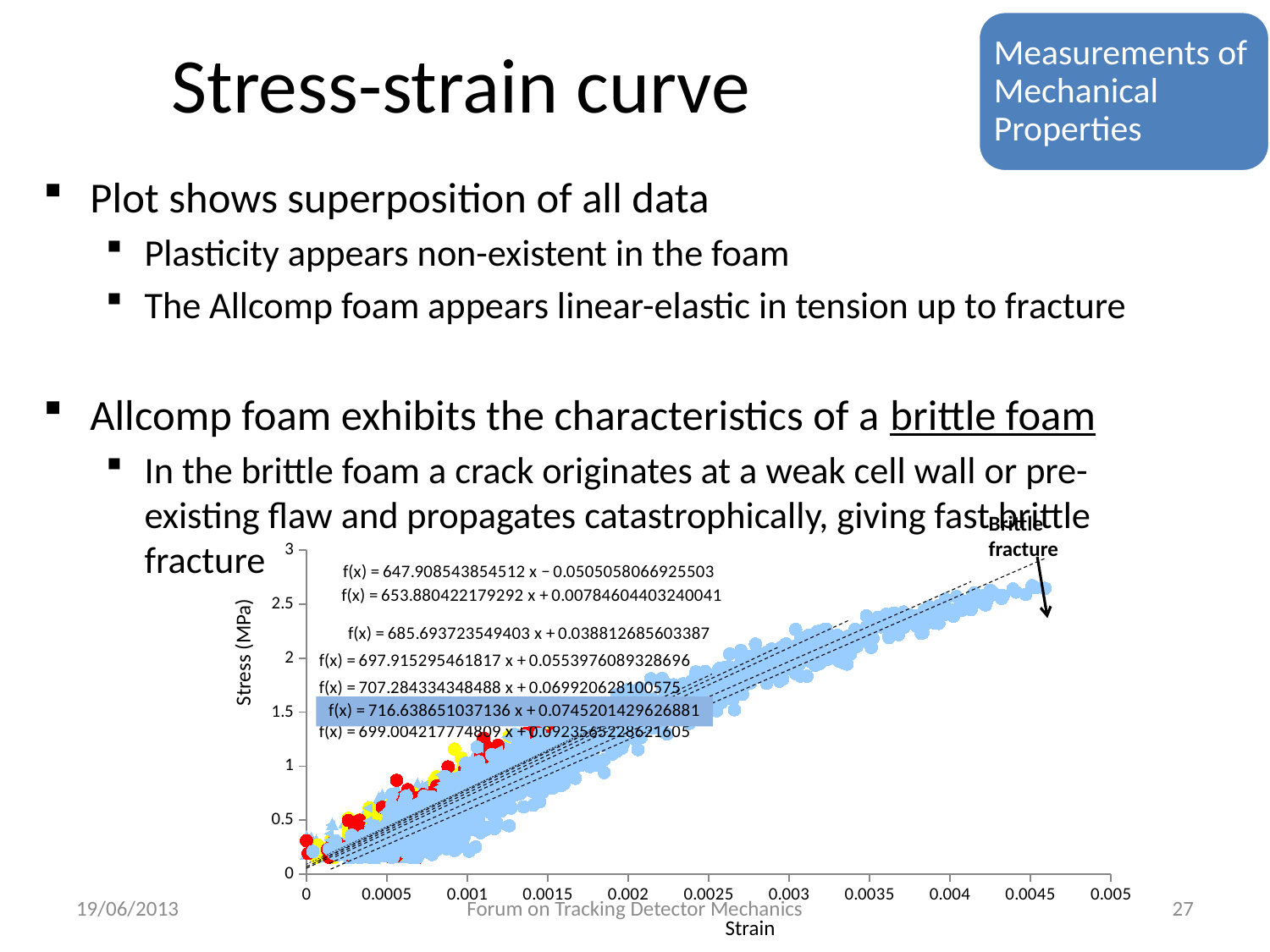
What is the maximum value shown on the Strain axis? 0.005 How many trendline equations are printed on the chart? 7 Is the stress value of the data points at a strain of 0.004 greater or less than 2? greater Do the plotted stress values rise or fall as strain increases along the x axis? rise What kind of chart is shown on the slide? scatter chart What is the label of the vertical axis of the chart? Stress (MPa) Which printed trendline equation has the smallest slope? f(x) = 647.908543854512 x − 0.0505058066925503 Is the stress value of the data points at a strain of 0.002 greater or less than 2? less What is the slope in the highlighted trendline equation on the chart? 716.638651037136 What is the label of the horizontal axis of the chart? Strain What annotation with an arrow is placed at the upper right end of the data in the chart? Brittle fracture Which printed trendline equation has the largest slope? f(x) = 716.638651037136 x + 0.0745201429626881